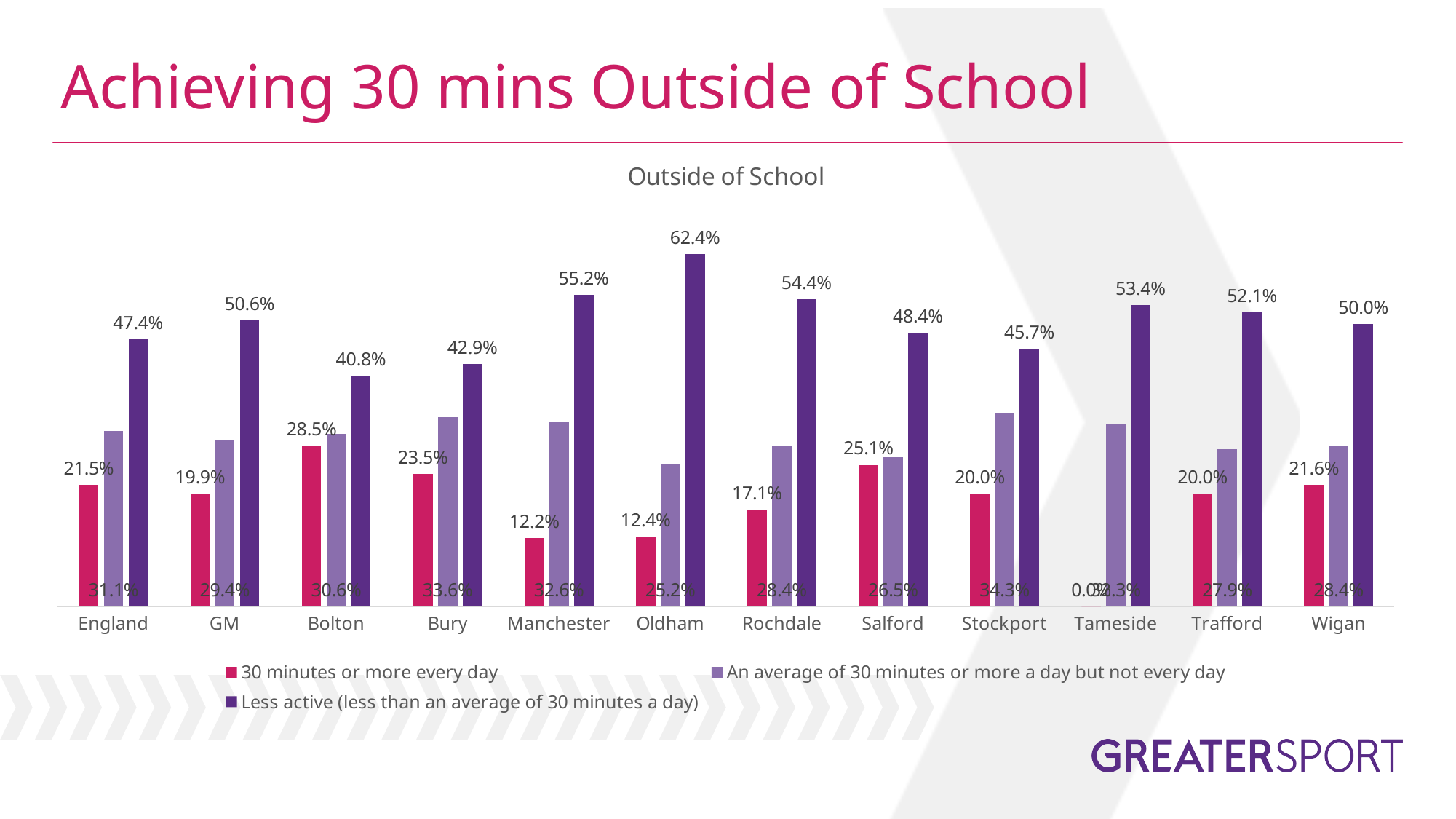
What kind of chart is shown on the slide? Bar chart Which area has the highest value in the 'Less active' series? Oldham What is the difference between Oldham's and Bolton's values in the 'Less active' series? 21.6% Which has the larger value in the 'Less active' series, Manchester or Rochdale? Manchester What is the value for Oldham in the 'Less active (less than an average of 30 minutes a day)' series? 62.4% For England, what is the difference between the 'Less active' value and the '30 minutes or more every day' value? 25.9% What is the value for Salford in the '30 minutes or more every day' series? 25.1% How many areas are shown on the x axis of the chart? 12 Which has the larger value in the '30 minutes or more every day' series, Bolton or Bury? Bolton How many series does the chart's legend list? 3 Which area has the lowest value in the 'Less active' series? Bolton What is the value for Stockport in the 'An average of 30 minutes or more a day but not every day' series? 34.3%